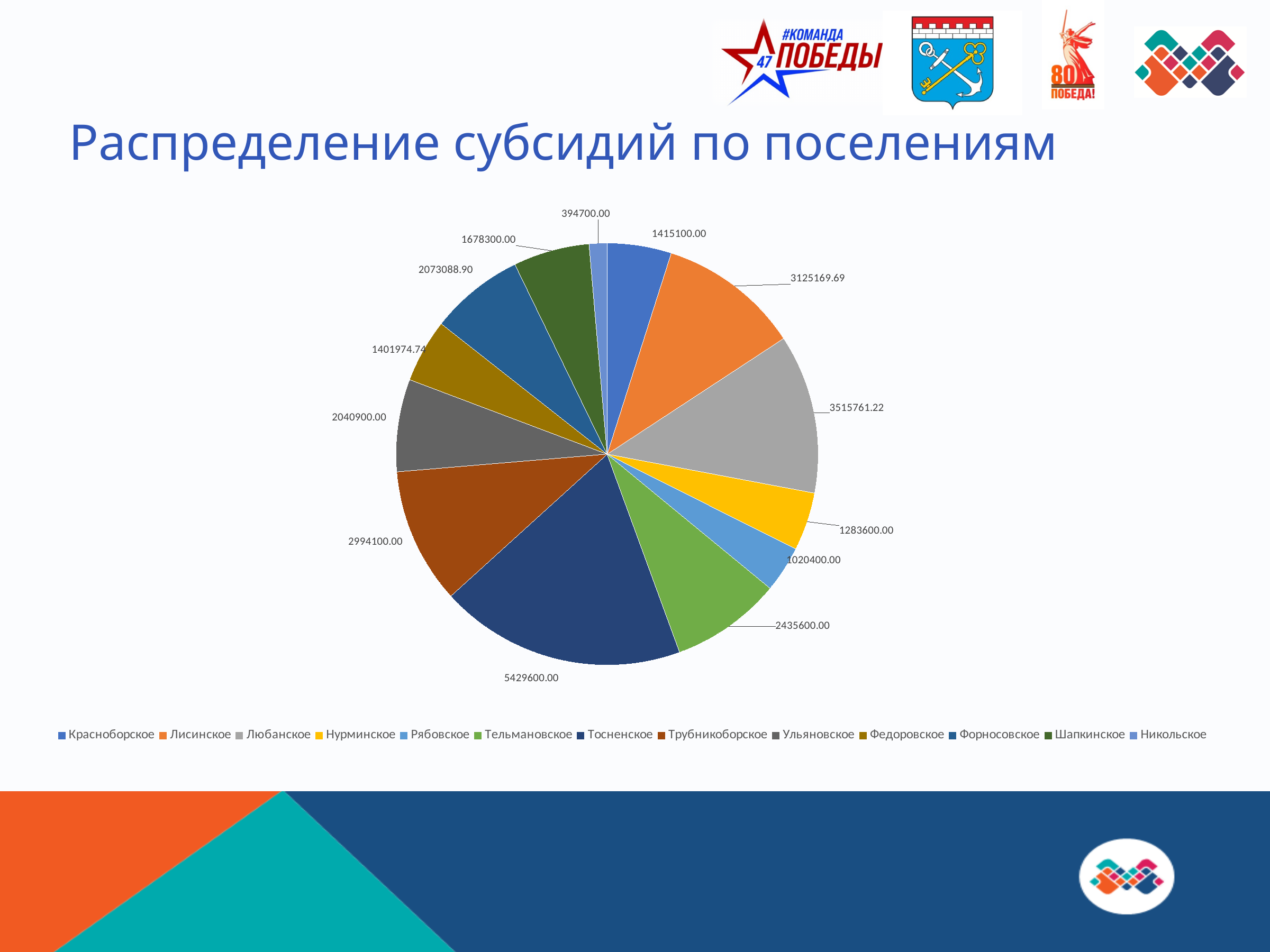
Which is larger, the value for Тельмановское or the value for Ульяновское? Тельмановское What is the difference between the values for Тосненское and Трубникоборское? 2435500.00 What is the value for Никольское? 394700.00 Which is larger, the value for Любанское or the value for Лисинское? Любанское What is the title of the chart on the slide? Распределение субсидий по поселениям How many settlements (slices) does the pie chart show? 13 What type of chart is shown on the slide? pie chart What is the value for Лисинское? 3125169.69 What is the value for Федоровское? 1401974.74 Which settlement has the largest slice of the pie? Тосненское Which settlement has the smallest slice of the pie? Никольское What is the value for Тосненское? 5429600.00